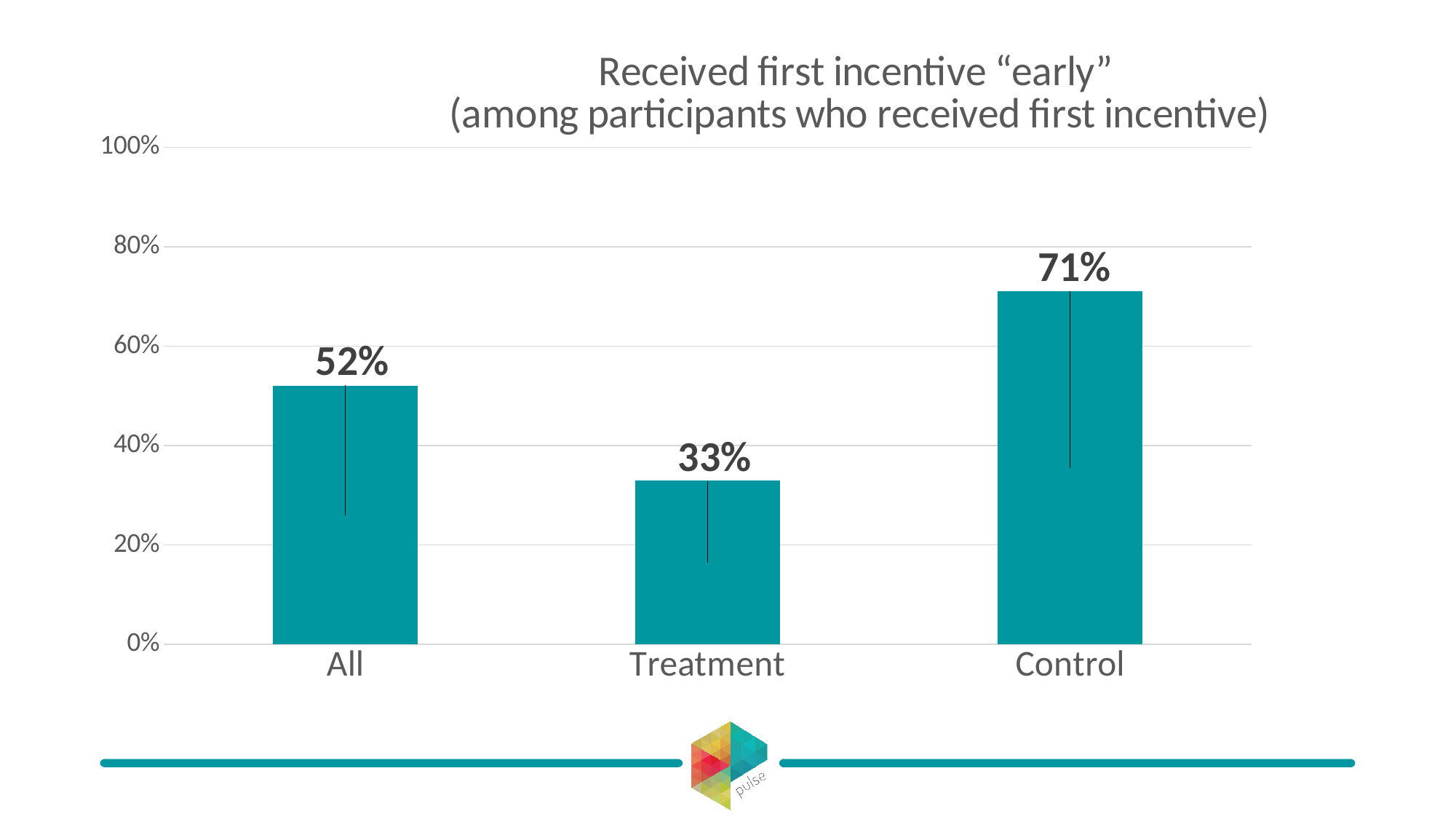
What kind of chart is shown on the slide? Bar chart What percentage of participants in the All group received the first incentive early? 52% How many groups are shown on the x axis? 3 What is the title of the chart? Received first incentive "early" (among participants who received first incentive) What is the difference in percentage points between the All group and the Treatment group? 19 Which group has the highest share of participants who received the first incentive early? Control Which is larger, the value for Treatment or the value for Control? Control What is the value shown for the Treatment group? 33% What is the difference in percentage points between the Control and Treatment groups? 38 Which group has the lowest value on the chart? Treatment Is the value for the All group greater or less than 60%? less What is the value shown for the Control group? 71%